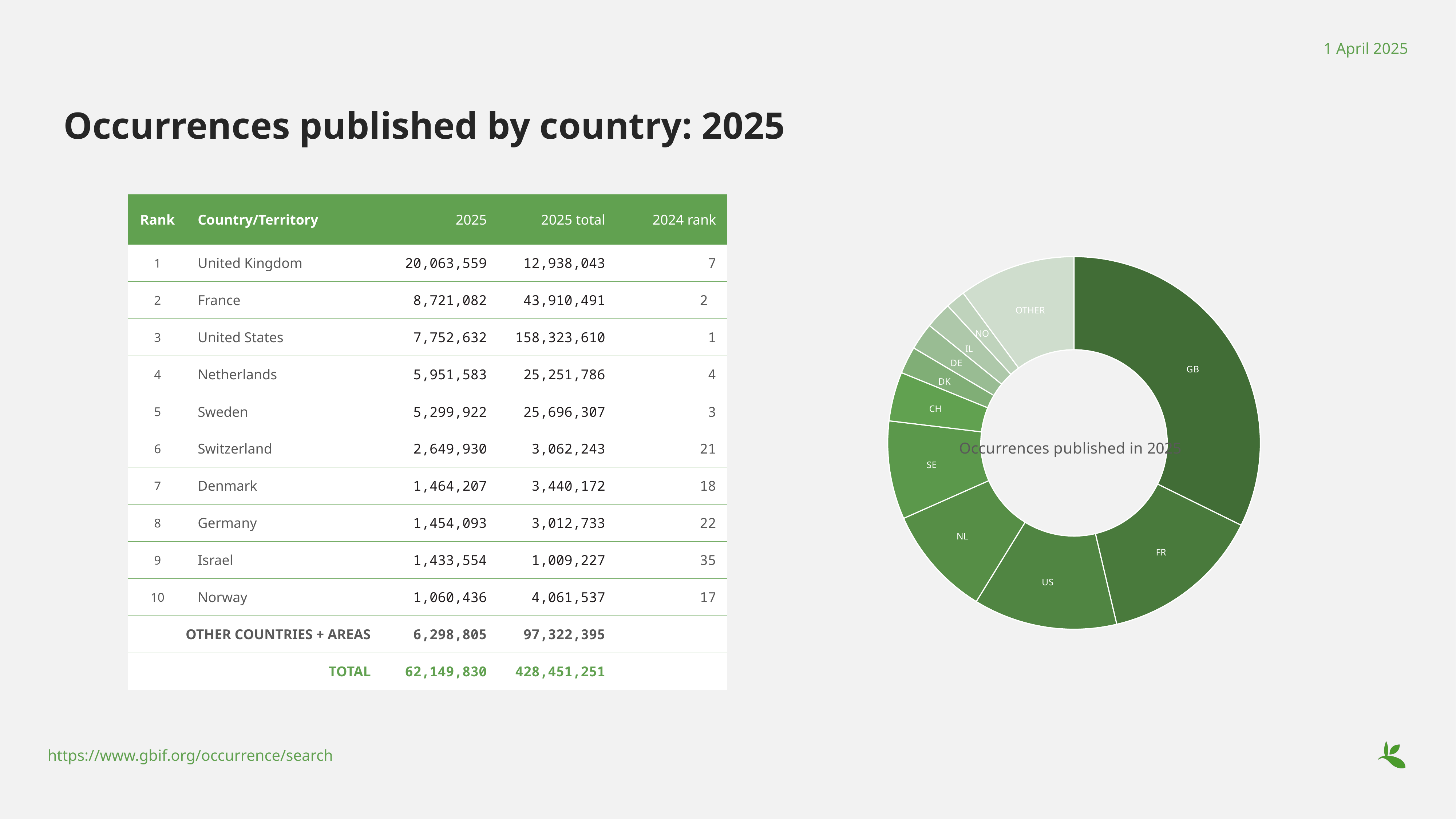
Which labelled country slice of the donut chart is the smallest? NO What is the 2025 value for the Netherlands (NL) shown on the slide? 5,951,583 What is the difference between the 2025 values for the United Kingdom and France? 11,342,477 Which slice of the donut chart is the largest? GB How many slices does the donut chart have? 11 In the donut chart, which slice is larger, GB or FR? GB What is the 2025 value for the United Kingdom (GB) shown on the slide? 20,063,559 What text is written in the centre of the donut chart? Occurrences published in 2025 What is the 2025 value for the OTHER COUNTRIES + AREAS slice shown on the slide? 6,298,805 In the donut chart, which slice is larger, CH or DK? CH What kind of chart is shown on the right of the slide? Donut (pie) chart In the donut chart, which slice is larger, FR or US? FR